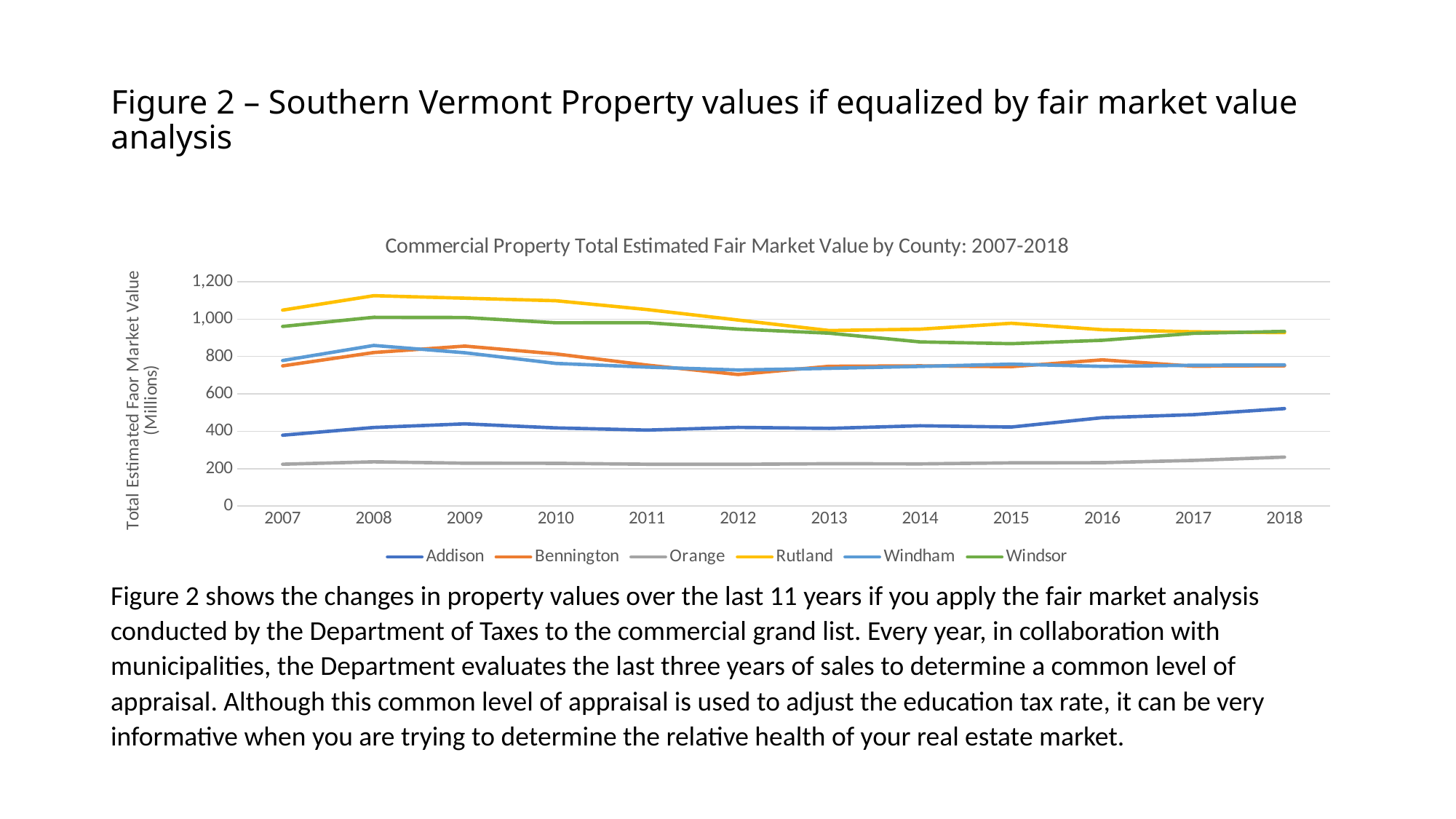
Does the value for Addison rise or fall from 2015 to 2018? Rise What kind of chart is shown on the slide? Line chart What is the title of the chart? Commercial Property Total Estimated Fair Market Value by County: 2007-2018 Does the value for Rutland rise or fall from 2008 to 2013? Fall How many series does the legend list? 6 How many years are shown along the x axis? 12 Which county has the highest commercial property fair market value in 2008? Rutland Is the value for Rutland in 2008 greater or less than 1,000? greater Which is larger in 2018, the value for Addison or the value for Orange? Addison Is the value for Addison in 2018 greater or less than 400? greater Is the value for Windham in 2018 greater or less than 800? less Which county has the lowest commercial property fair market value across the whole period? Orange